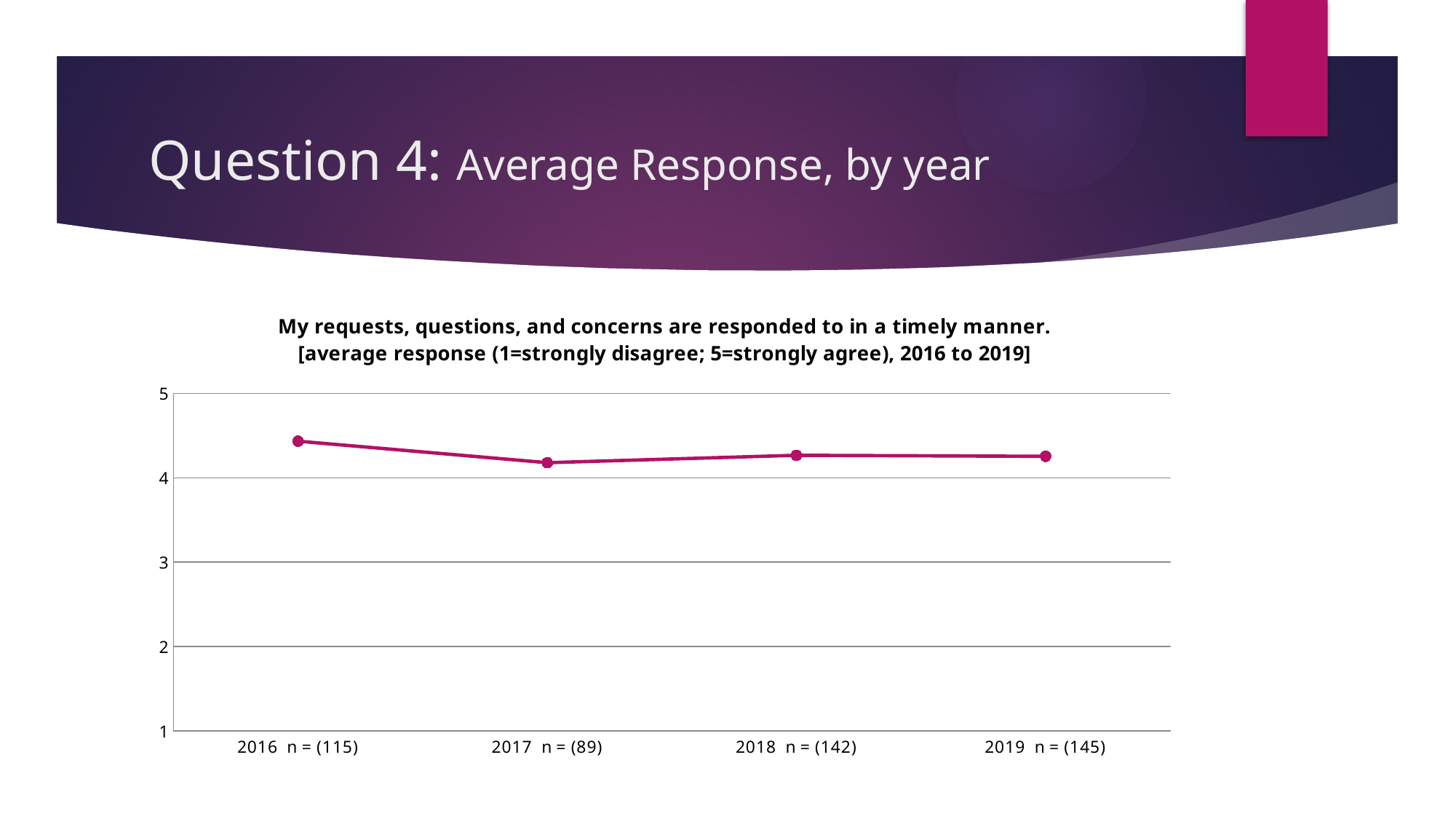
Which year has the lowest average response? 2017 Which year has the larger average response, 2016 or 2017? 2016 Is the average response for 2016 greater or less than 4? greater How many years (data points) are plotted on the chart? 4 Does the average response rise or fall from 2016 to 2017? fall Is the average response for 2017 greater or less than 4? greater Is the average response for 2019 greater or less than 5? less What is the sample size (n) shown for 2017? 89 Which year has the highest average response? 2016 Does the average response rise or fall from 2017 to 2018? rise What is the sample size (n) shown for 2019? 145 What kind of chart is shown on the slide? line chart